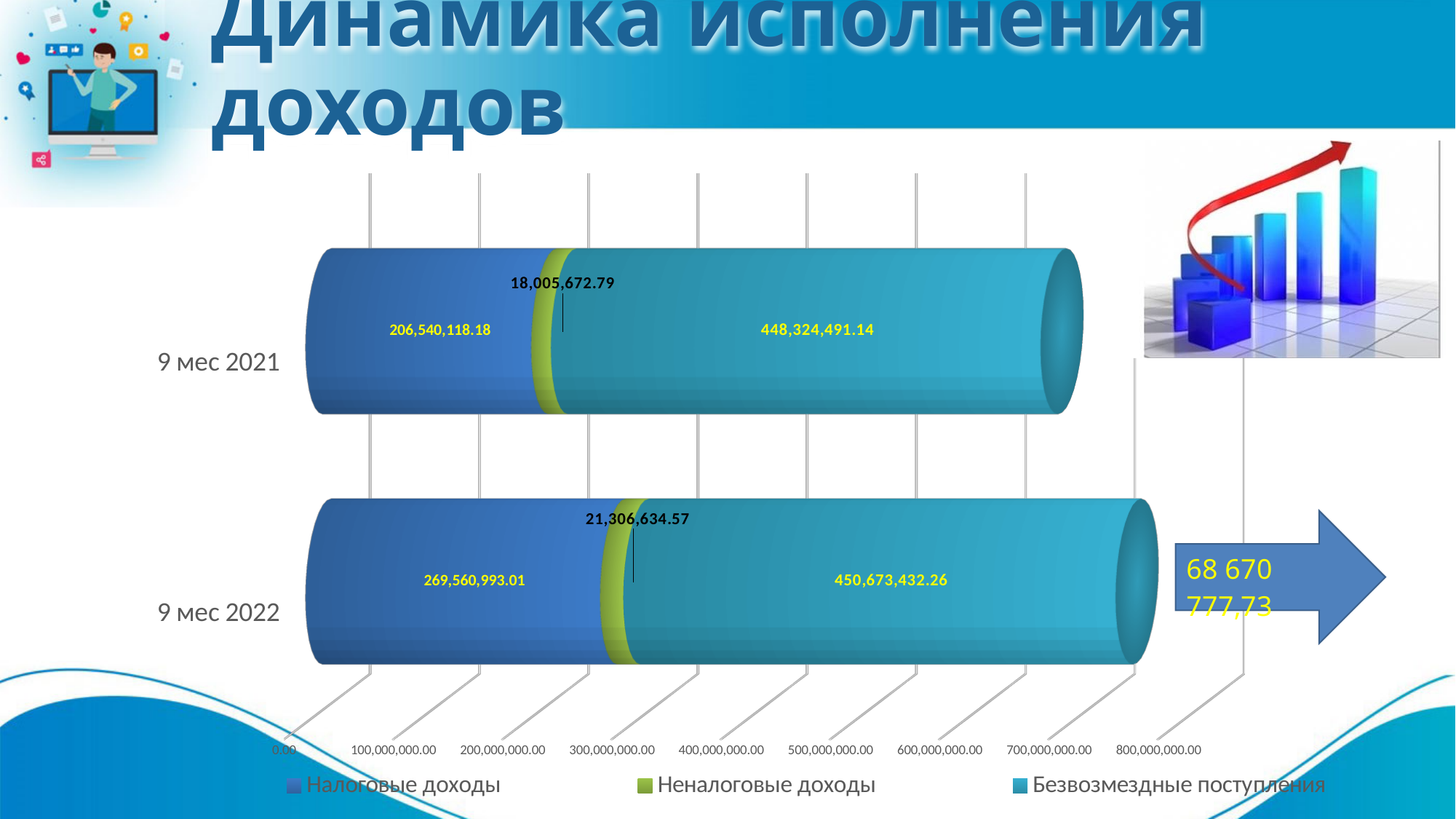
What is the value of Налоговые доходы for 9 мес 2021? 206,540,118.18 How many categories (periods) are shown on the chart? 2 What is the difference in Налоговые доходы between 9 мес 2022 and 9 мес 2021? 63,020,874.83 What is the value of Налоговые доходы for 9 мес 2022? 269,560,993.01 What is the total of the stacked bar for 9 мес 2022? 741,541,059.84 Which period has the larger value for Неналоговые доходы, 9 мес 2021 or 9 мес 2022? 9 мес 2022 What type of chart is shown on the slide? bar chart How many series does the legend list? 3 Which series has the lowest value for 9 мес 2021? Неналоговые доходы What is the value of Неналоговые доходы for 9 мес 2022? 21,306,634.57 What is the value of Безвозмездные поступления for 9 мес 2021? 448,324,491.14 Which series has the highest value for 9 мес 2022? Безвозмездные поступления